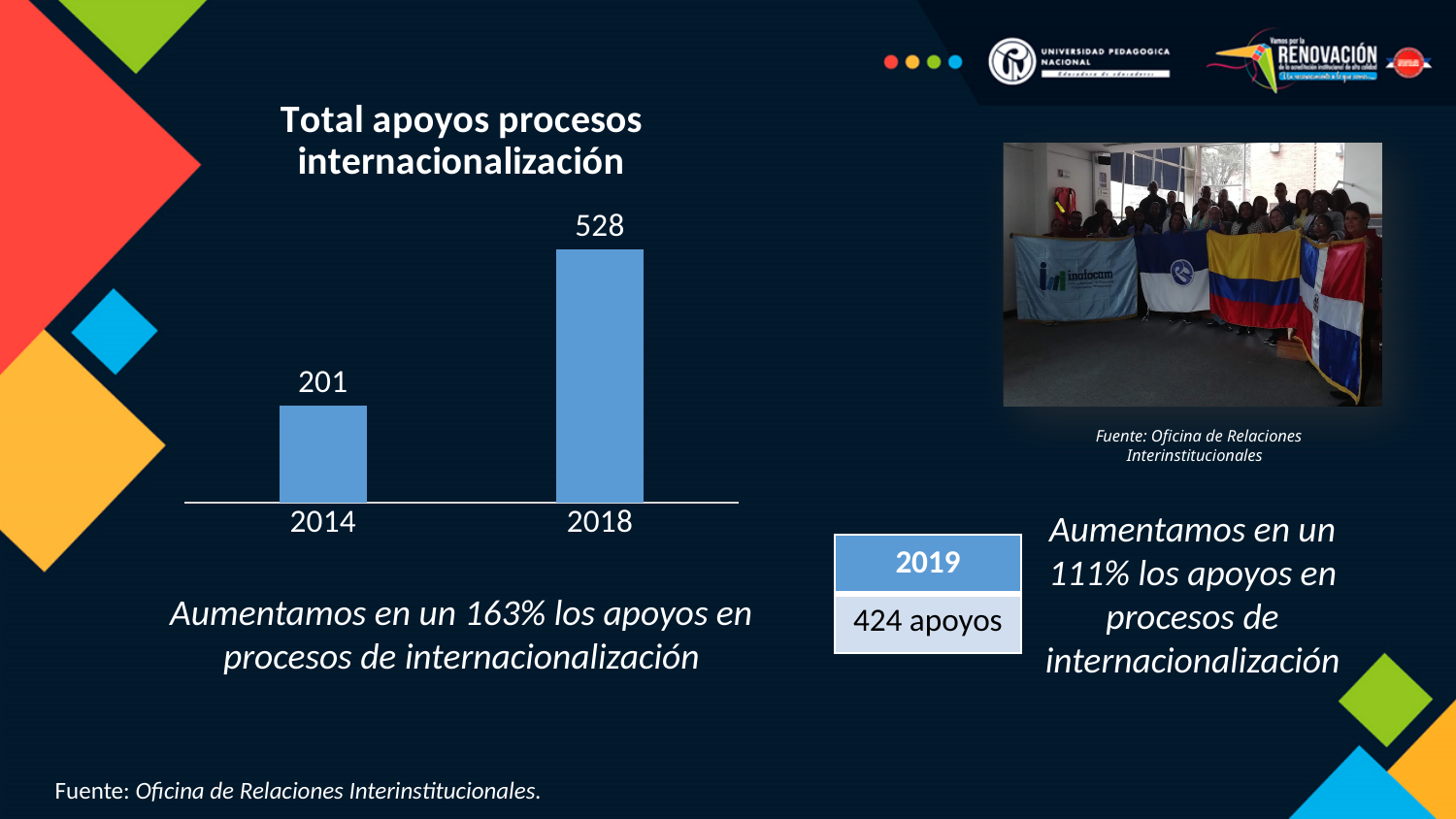
Which year has the lower value in the chart? 2014 What is the value for 2018 in the chart? 528 What is the difference between the values for 2018 and 2014? 327 What kind of chart is shown on the slide? bar chart Which year has the higher value in the chart? 2018 How many bars are plotted in the chart? 2 Do the values rise or fall from 2014 to 2018? rise Is the value for 2018 larger or smaller than the value for 2014? larger What colour are the bars in the chart? blue What is the title of the chart? Total apoyos procesos internacionalización What is the value for 2014 in the chart? 201